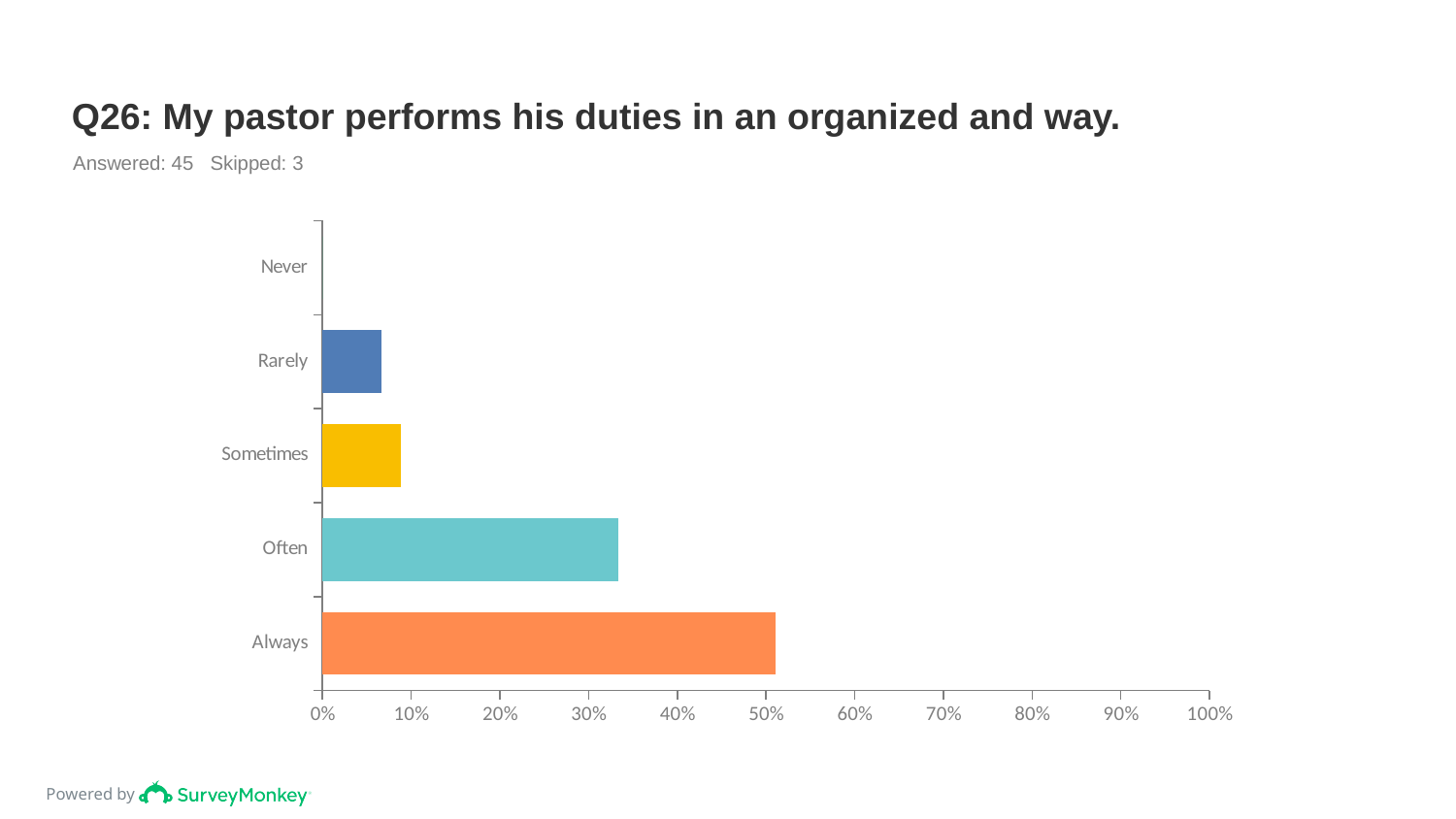
Is the value for Rarely greater or less than 10%? less Which response category has the highest value? Always Is the value for Always greater or less than 60%? less Is the value for Often greater or less than 30%? greater Do the values rise or fall going down the categories from Never to Always? rise What kind of chart is shown on the slide? bar chart Which response category has the lowest value? Never What is the title of the chart? Q26: My pastor performs his duties in an organized and way. How many response categories are shown on the chart? 5 Which has a larger value, Often or Sometimes? Often